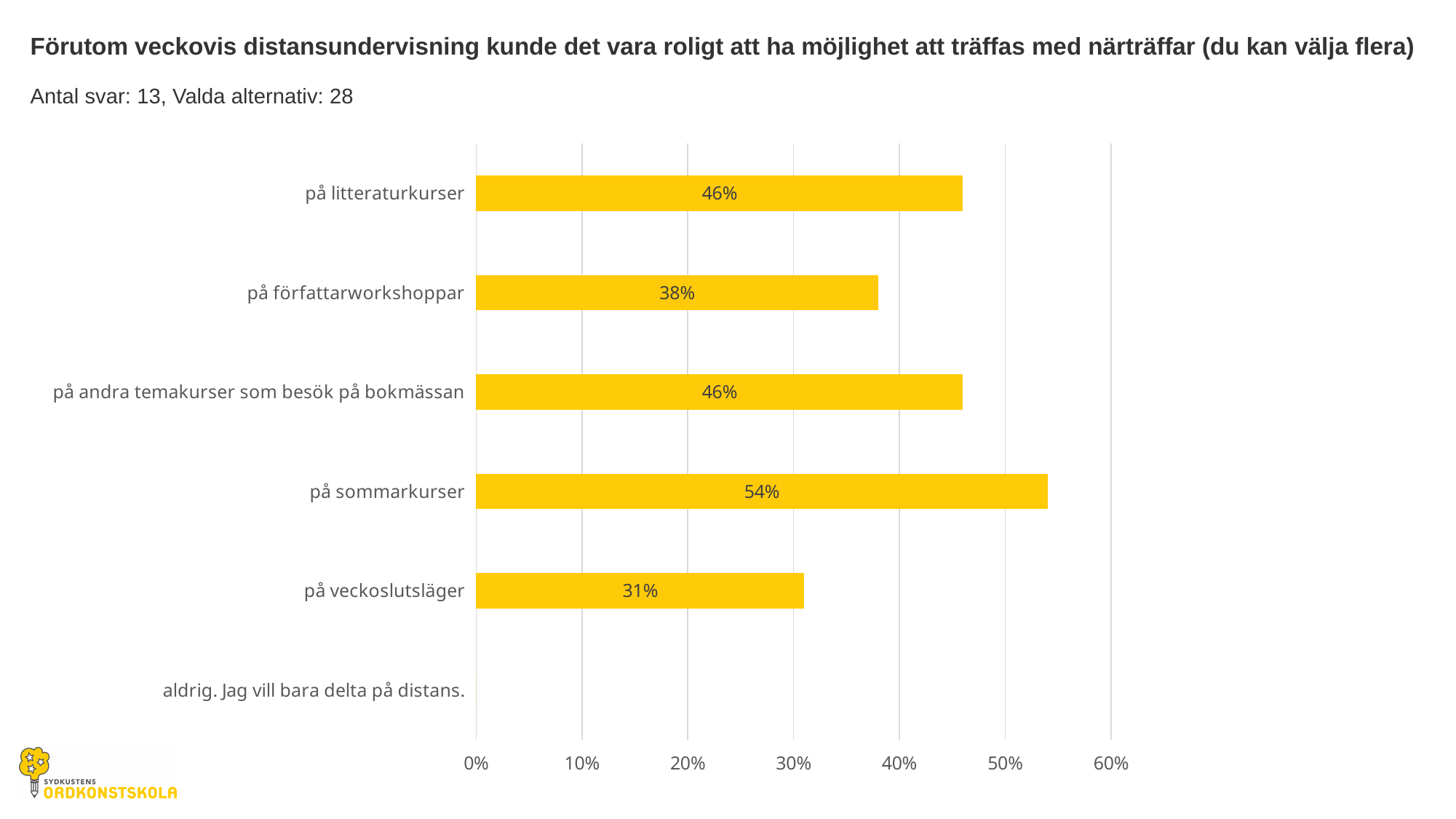
What is the difference between the values for "på sommarkurser" and "på veckoslutsläger"? 23% How many categories are shown on the chart? 6 Which category has the lowest value? aldrig. Jag vill bara delta på distans. What kind of chart is shown on the slide? bar chart What is the value for "på författarworkshoppar"? 38% What is the value for "på sommarkurser"? 54% What is the value for "på veckoslutsläger"? 31% How many responses (Antal svar) does the slide report? 13 Which category has the highest value? på sommarkurser Is the value for "på sommarkurser" greater or less than 50%? greater Which is larger, the value for "på författarworkshoppar" or the value for "på veckoslutsläger"? på författarworkshoppar What is the value for "på litteraturkurser"? 46%